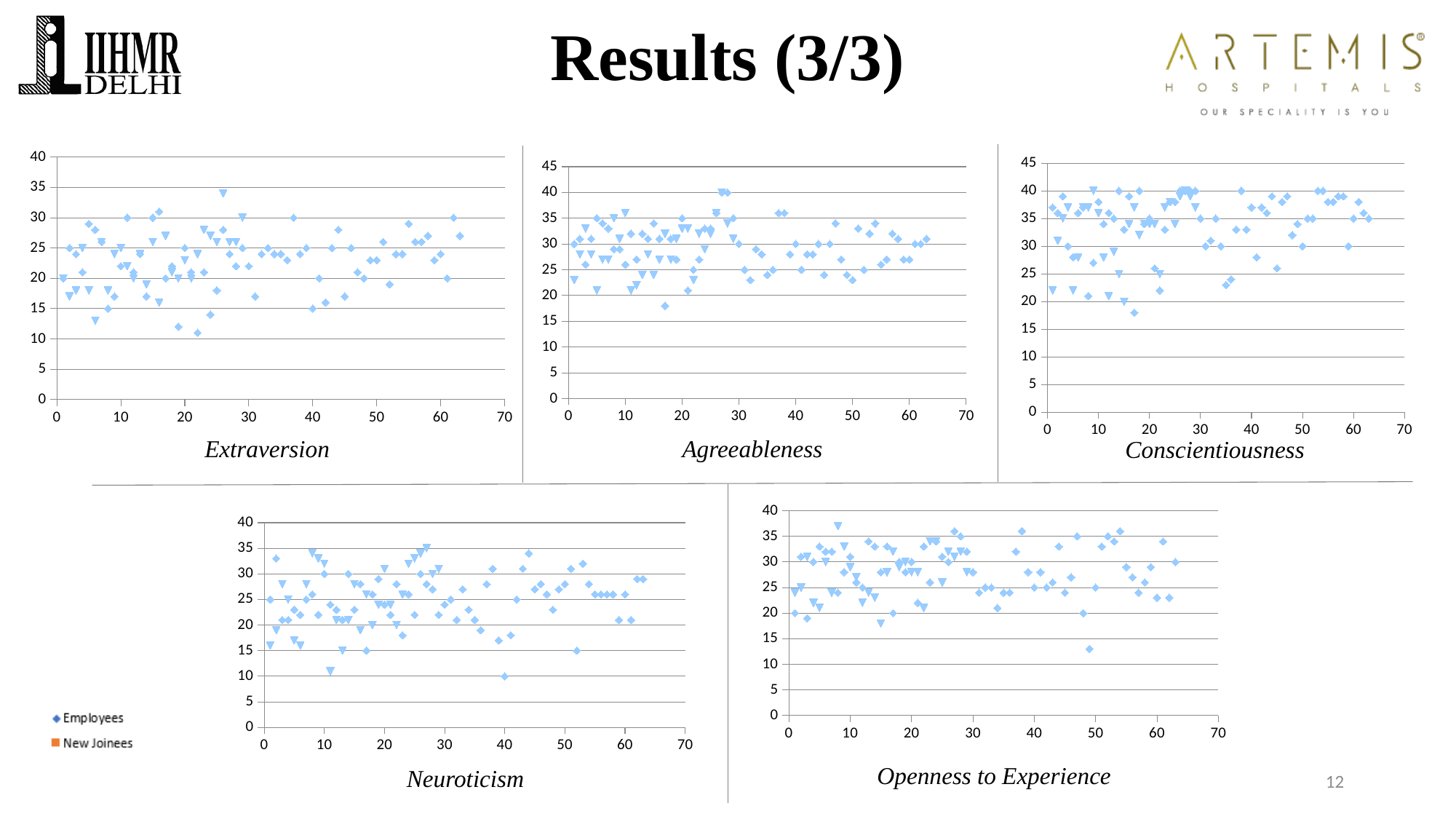
In the Neuroticism chart, is the highest plotted value greater or less than 30? greater In the Conscientiousness chart, is the highest plotted value greater or less than 35? greater In the Openness to Experience chart, is the lowest plotted value greater or less than 15? less What kind of chart is the Extraversion chart? scatter chart How many charts are shown on the slide? 5 What are the two entries in the legend? Employees, New Joinees How many series does the legend on the slide list? 2 What is the maximum value shown on the y-axis of the Agreeableness chart? 45